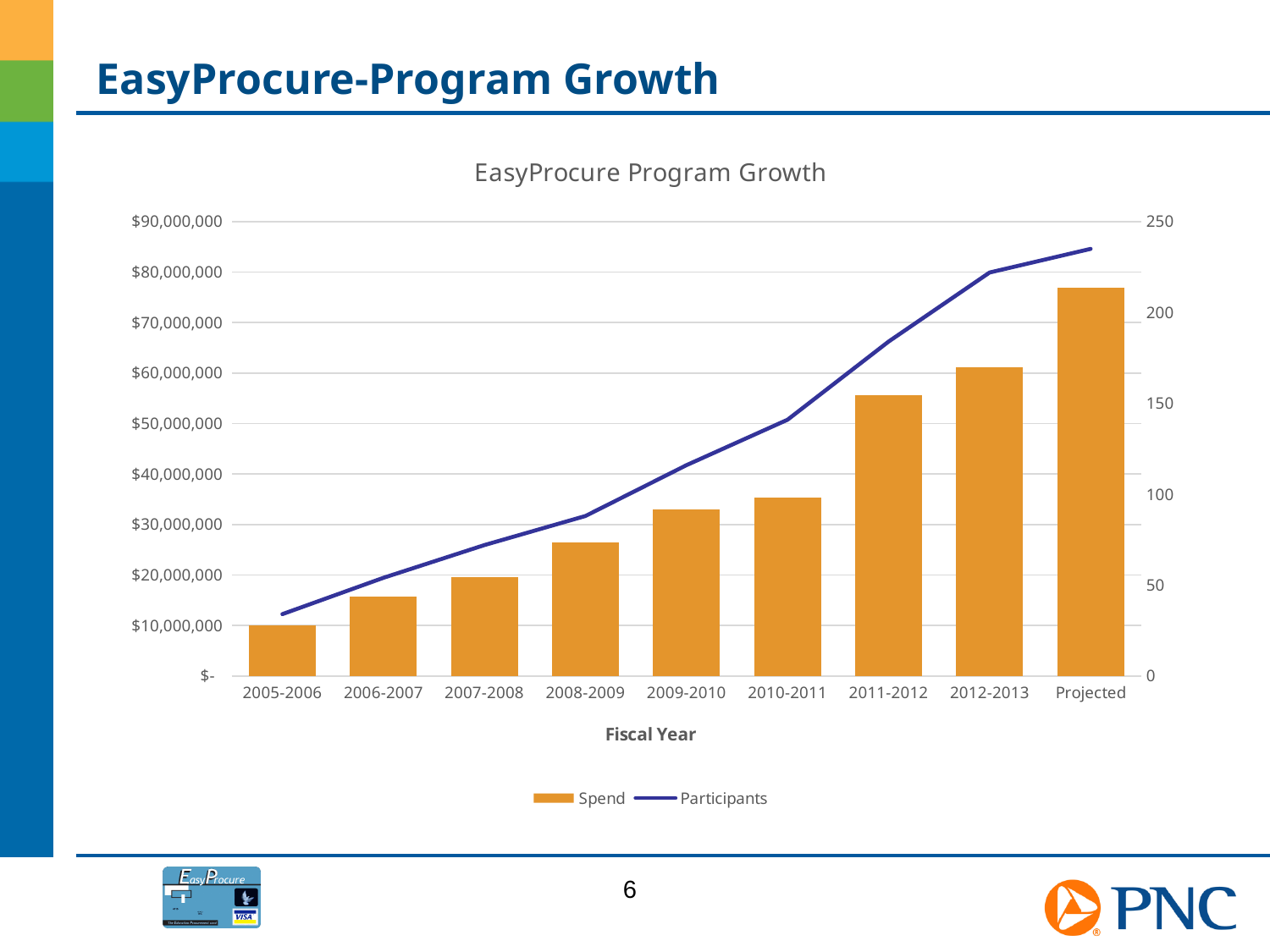
Is the Participants value for Projected greater or less than 200? greater Is the Spend value for 2011-2012 greater or less than $50,000,000? greater What is the title of the x axis? Fiscal Year What kind of chart is shown on the slide? A combination bar and line chart Which has the larger Spend, 2012-2013 or 2010-2011? 2012-2013 Is the Spend value for 2008-2009 greater or less than $30,000,000? less How many fiscal year categories are shown on the x axis? 9 Which fiscal year has the highest Spend bar? Projected Do the Participants values rise or fall across the fiscal years from 2005-2006 to Projected? rise How many series does the legend list? 2 Which fiscal year has the lowest Spend bar? 2005-2006